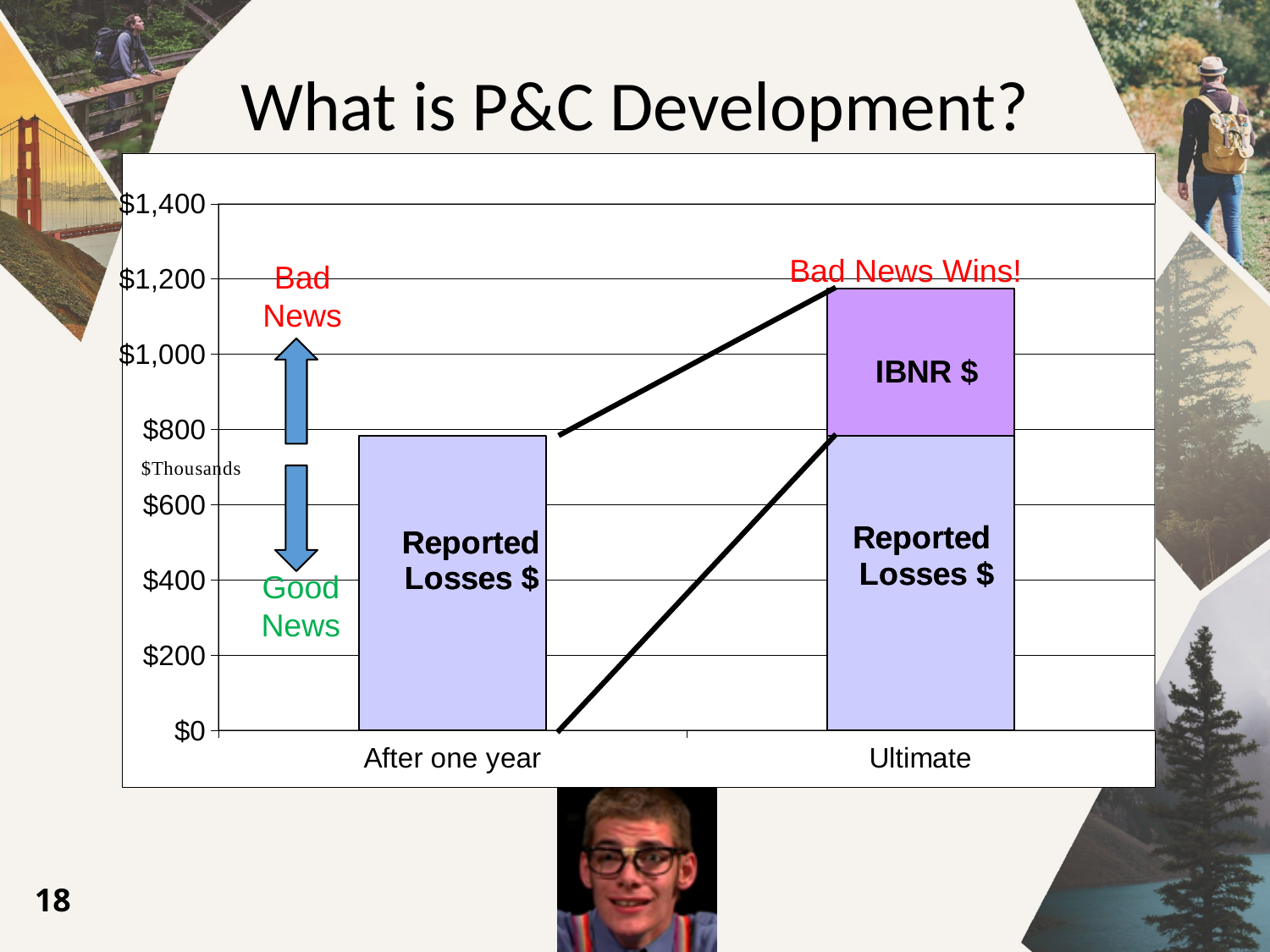
Is the total value of the Ultimate bar greater or less than $1,000? greater What unit label is shown on the y axis of the chart? $Thousands Is the Reported Losses value for After one year greater or less than $1,000? less What are the two categories on the x axis of the chart? After one year; Ultimate Is the IBNR $ segment in the Ultimate bar greater or less than $600 in size? less What kind of chart is shown on the slide? Stacked bar chart How many categories are shown on the x axis of the chart? 2 How many stacked segments (series) make up the Ultimate bar? 2 Do the total losses rise or fall from After one year to Ultimate? rise What is the highest value shown on the y axis of the chart? $1,400 Which category has the taller total bar, After one year or Ultimate? Ultimate